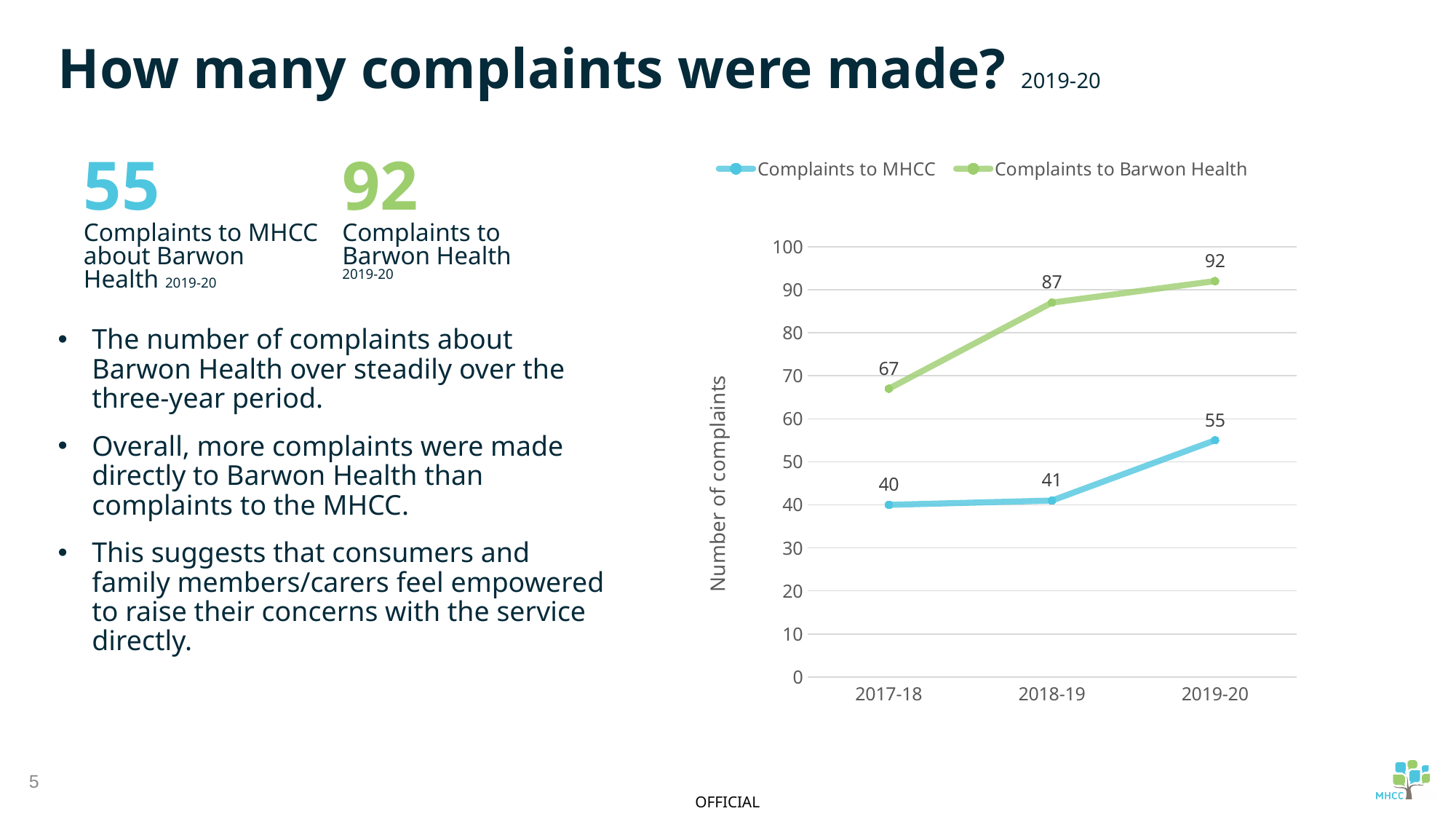
What is the label on the y axis of the chart? Number of complaints What is the value for Complaints to MHCC in 2019-20? 55 What kind of chart is shown on the slide? line chart In which year is the value for Complaints to MHCC lowest? 2017-18 Which is larger in 2017-18: Complaints to MHCC or Complaints to Barwon Health? Complaints to Barwon Health In which year is the value for Complaints to Barwon Health highest? 2019-20 How many series does the legend list? 2 How many points are plotted along the x axis for each series? 3 What is the difference between Complaints to Barwon Health and Complaints to MHCC in 2019-20? 37 What is the value for Complaints to Barwon Health in 2018-19? 87 What is the value for Complaints to MHCC in 2017-18? 40 Do the values for Complaints to Barwon Health rise or fall from 2017-18 to 2019-20? rise